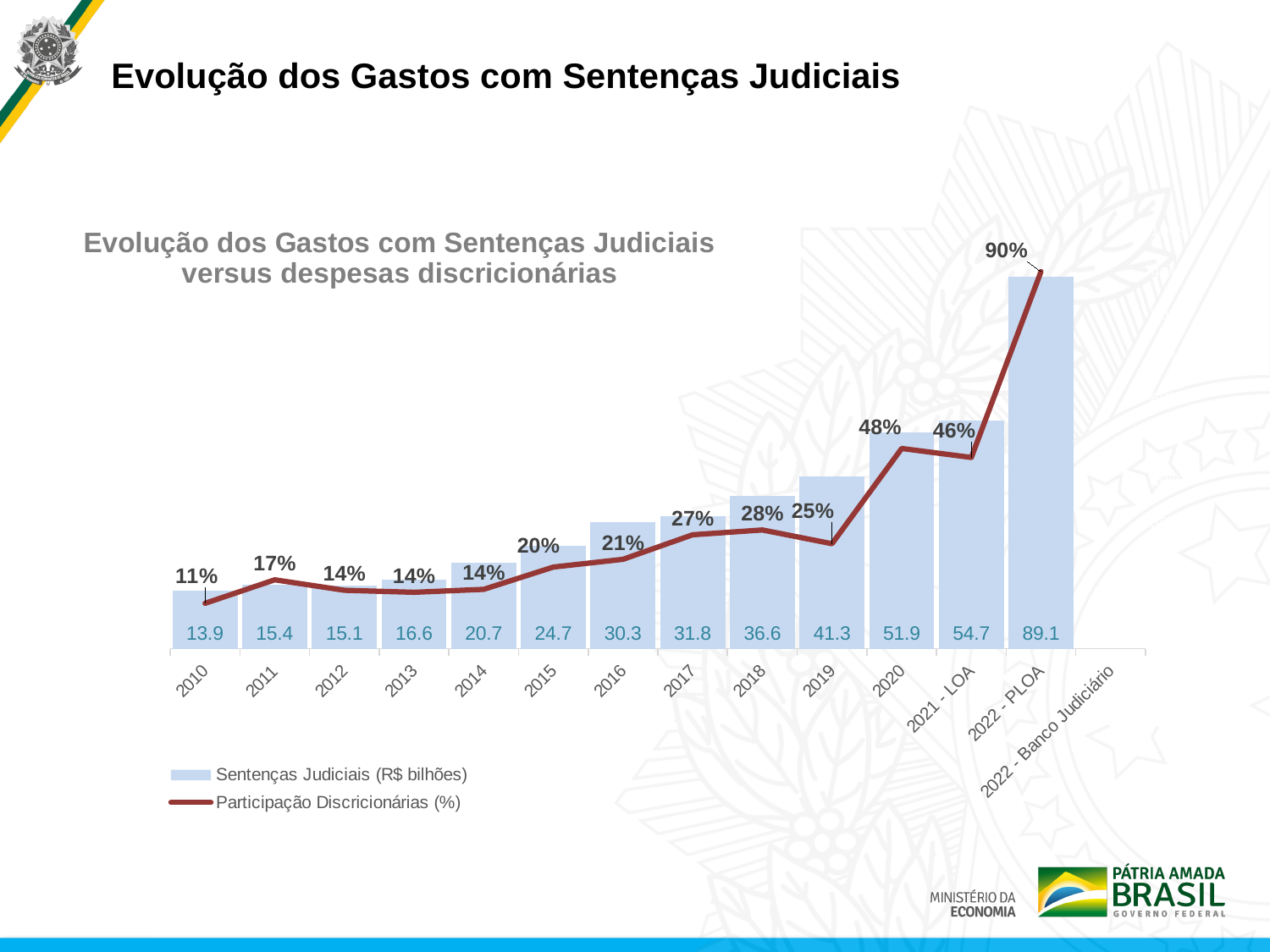
Which is larger, the Sentenças Judiciais value for 2011 or for 2012? 2011 What kind of chart is shown? Combined bar and line chart What is the value of Sentenças Judiciais (R$ bilhões) for 2022 - PLOA? 89.1 Which year has the lowest Sentenças Judiciais (R$ bilhões) value? 2010 Do the Sentenças Judiciais (R$ bilhões) values generally rise or fall from 2010 to 2022 - PLOA? Rise What is the difference in Sentenças Judiciais (R$ bilhões) between 2022 - PLOA and 2021 - LOA? 34.4 What is the value of Sentenças Judiciais (R$ bilhões) for 2015? 24.7 What is the Participação Discricionárias (%) value for 2020? 48% Which category has the highest Sentenças Judiciais (R$ bilhões) value? 2022 - PLOA Which is larger, the Participação Discricionárias (%) for 2018 or for 2019? 2018 How many bars are plotted for Sentenças Judiciais (R$ bilhões)? 13 How many series does the legend list? 2